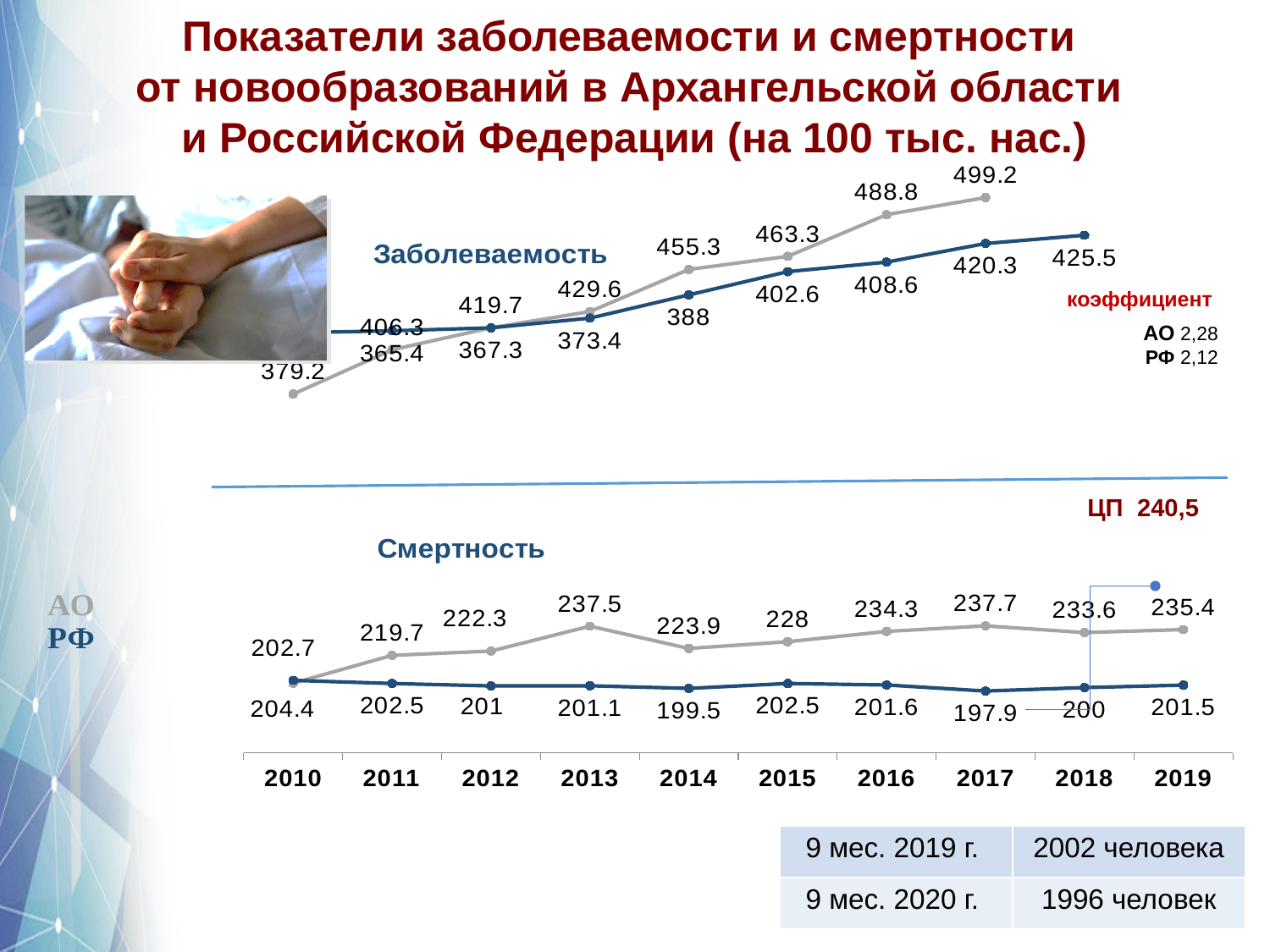
How many series are plotted on the Смертность chart? 2 On the Заболеваемость chart, what is the highest value labelled? 499.2 On the Смертность chart, in which year is the РФ value lowest? 2017 On the Смертность chart, what is the РФ value for 2017? 197.9 On the Смертность chart, which series has the larger value in 2010, АО or РФ? РФ On the Смертность chart, what is the difference between the АО and РФ values in 2017? 39.8 On the Смертность chart, in which year is the АО value lowest? 2010 How many years are shown on the x axis of the Смертность chart? 10 What kind of chart is the Смертность chart? line chart On the Смертность chart, what is the АО value for 2019? 235.4 On the Смертность chart, what is the АО value for 2013? 237.5 On the Смертность chart, what is the difference between the АО and РФ values in 2019? 33.9